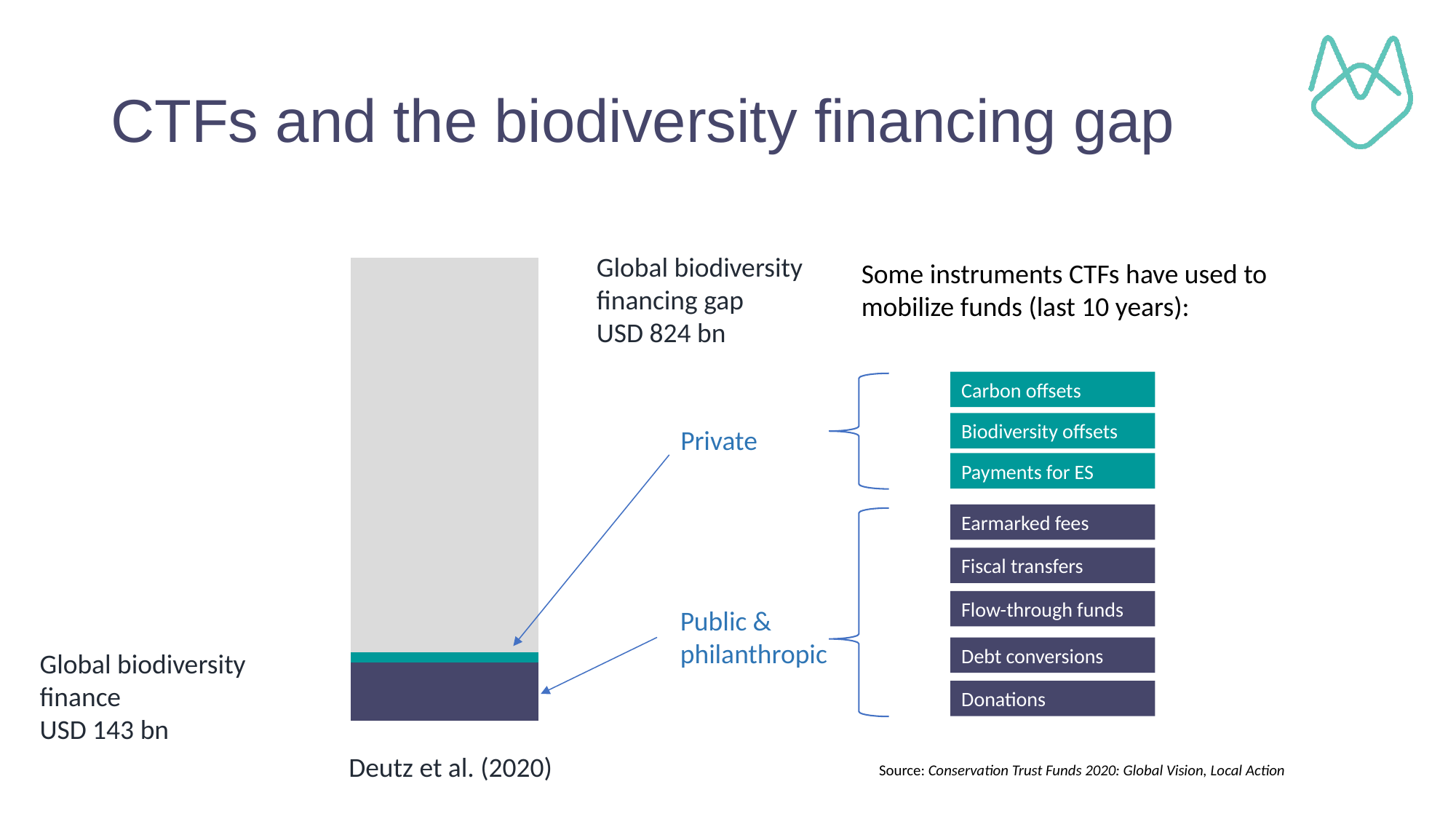
What is the combined total of global biodiversity finance and the financing gap shown in the stacked bar? USD 967 bn What kind of chart is shown on the slide? Stacked bar chart What is the difference between the global biodiversity financing gap and global biodiversity finance? USD 681 bn What colour is the Private segment of the bar? Teal Which segment of the stacked bar is the largest? Global biodiversity financing gap What is the value of the global biodiversity financing gap shown on the chart? USD 824 bn Which segment of global biodiversity finance is larger, Private or Public & philanthropic? Public & philanthropic Which is larger, the global biodiversity financing gap or global biodiversity finance? Global biodiversity financing gap How many segments make up the stacked bar? 3 Which segment of the stacked bar is the smallest? Private What source is cited beneath the bar chart? Deutz et al. (2020) What is the value of global biodiversity finance shown on the chart? USD 143 bn